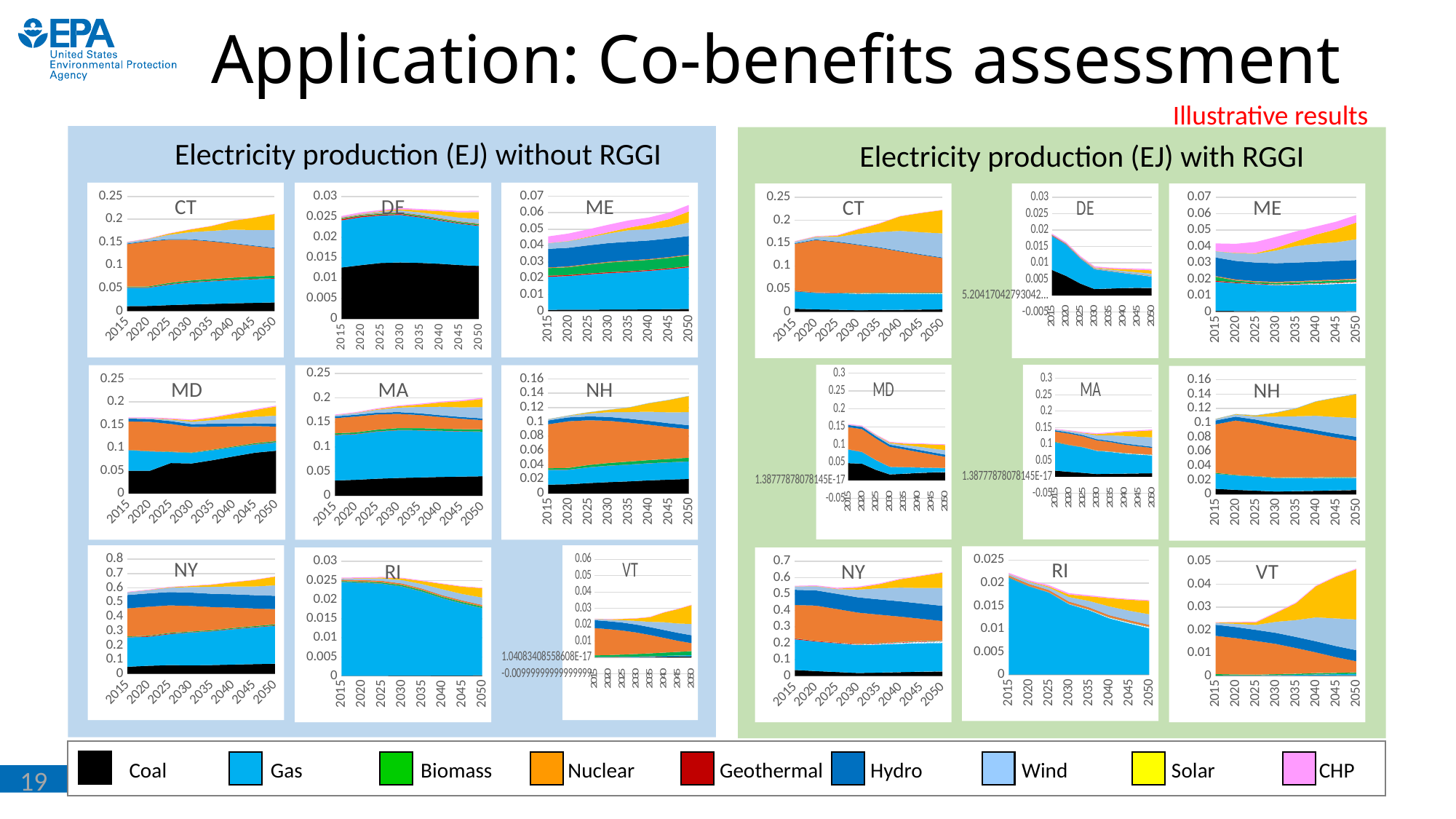
How many series does the legend at the bottom of the slide list? 9 In the 'Electricity production (EJ) with RGGI' panel, does the total electricity production for VT rise or fall from 2015 to 2050? rise In the 'Electricity production (EJ) with RGGI' panel, is the total electricity production for RI in 2050 greater or less than 0.02? less What kind of chart is used for each state in the 'Electricity production (EJ) without RGGI' panel? area chart What is the title of the left (blue) panel of charts? Electricity production (EJ) without RGGI Which colour represents Coal in the legend? black In the 'Electricity production (EJ) with RGGI' panel, does the total electricity production for RI rise or fall from 2015 to 2050? fall In the 'Electricity production (EJ) with RGGI' panel, is the total electricity production for VT in 2050 greater or less than 0.04? greater In the 'Electricity production (EJ) without RGGI' panel, is the total electricity production for NY in 2050 greater or less than 0.6? greater In the 'Electricity production (EJ) without RGGI' panel, how many years are plotted along the x axis of the NY chart? 8 How many state charts are shown in the 'Electricity production (EJ) with RGGI' panel? 9